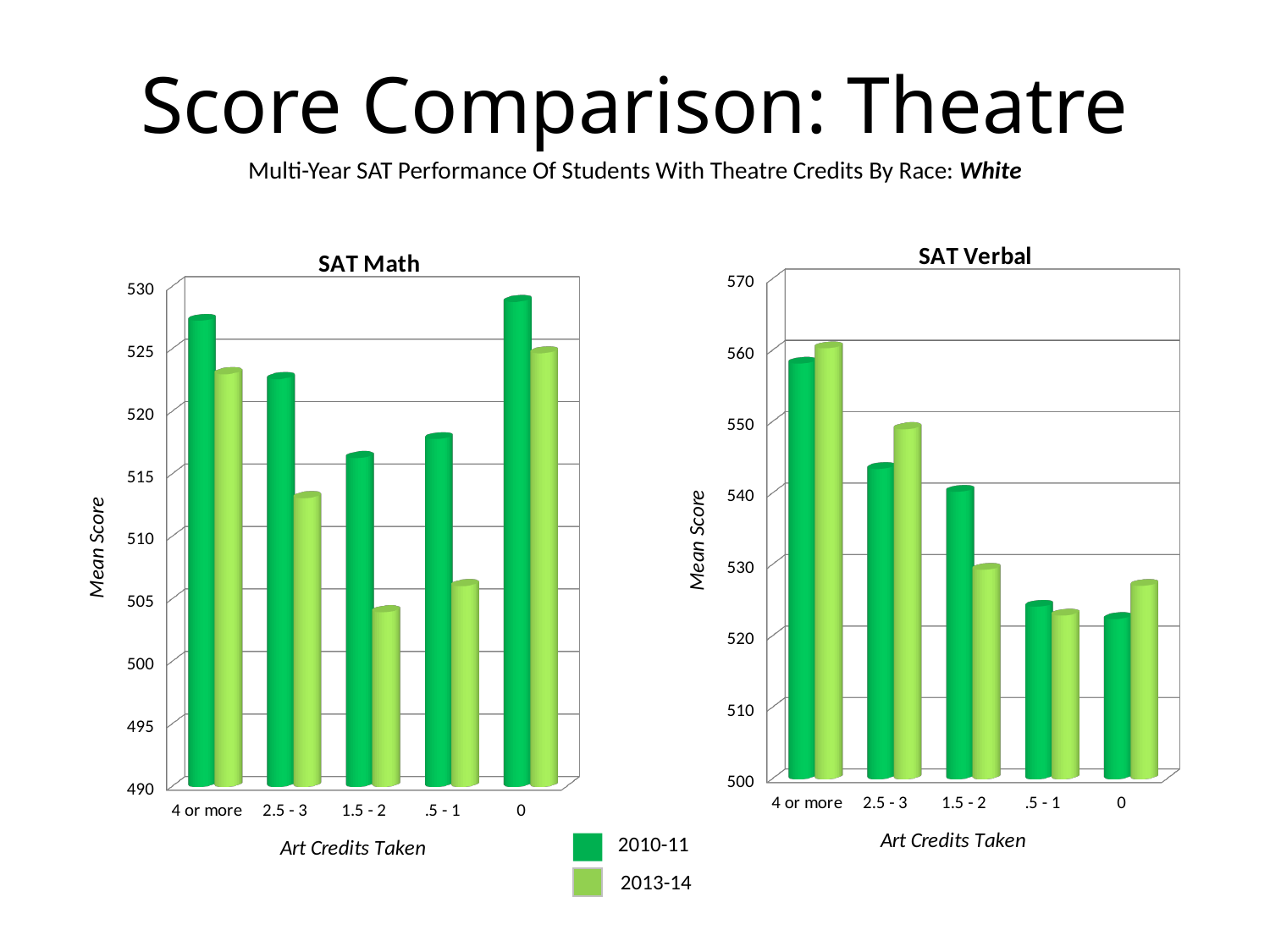
In the SAT Verbal chart, for 2.5 - 3 credits, which series has the larger value, 2010-11 or 2013-14? 2013-14 In the SAT Verbal chart, do the 2010-11 values generally rise or fall moving from 4 or more to 0 credits? fall How many series does the legend list? 2 In the SAT Math chart, which Art Credits Taken category has the lowest 2013-14 mean score? 1.5 - 2 In the SAT Verbal chart, is the 2010-11 value for 4 or more greater or less than 550? greater What kind of chart is the SAT Math chart? bar chart In the SAT Verbal chart, which Art Credits Taken category has the highest 2013-14 mean score? 4 or more What is the y-axis title on the SAT Verbal chart? Mean Score In the SAT Math chart, how many Art Credits Taken categories are shown on the x axis? 5 In the SAT Math chart, for 4 or more credits, which series has the larger value, 2010-11 or 2013-14? 2010-11 In the SAT Math chart, is the 2010-11 value for 0 credits greater or less than 525? greater In the SAT Math chart, is the 2013-14 value for 1.5 - 2 greater or less than 510? less